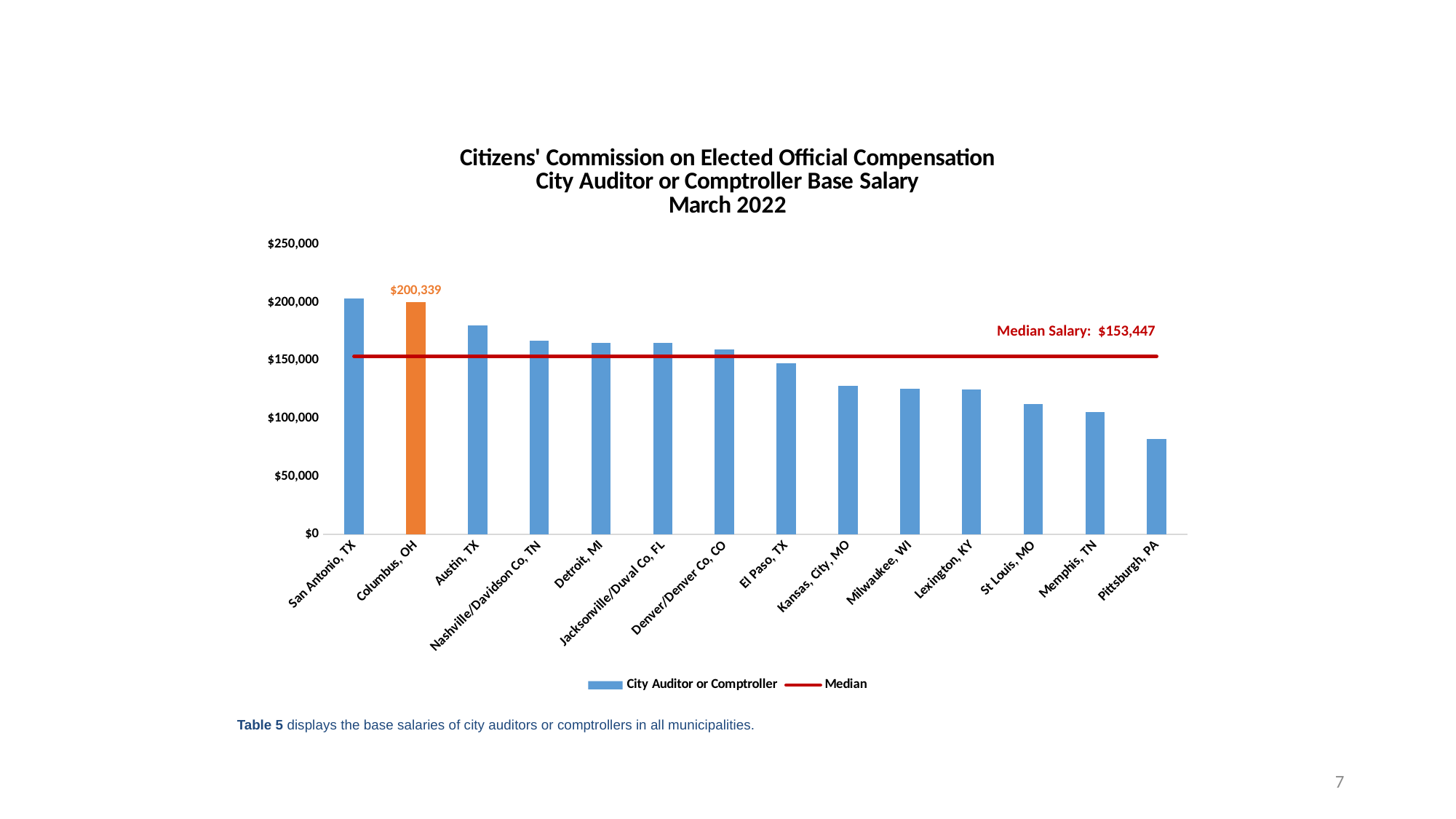
Which has the larger base salary, Austin, TX or Detroit, MI? Austin, TX Which bar is highlighted in orange? Columbus, OH What kind of chart is this? Bar chart Is the value for Pittsburgh, PA greater or less than $100,000? less How many series does the legend list? 2 How many cities are shown on the x axis? 14 Do the base salaries rise or fall from left to right along the x axis? Fall Is the value for Austin, TX greater or less than $200,000? less What is the median salary shown on the chart? $153,447 What is the base salary shown for Columbus, OH? $200,339 Which city has the lowest City Auditor or Comptroller base salary? Pittsburgh, PA Is the value for Detroit, MI greater or less than $150,000? greater